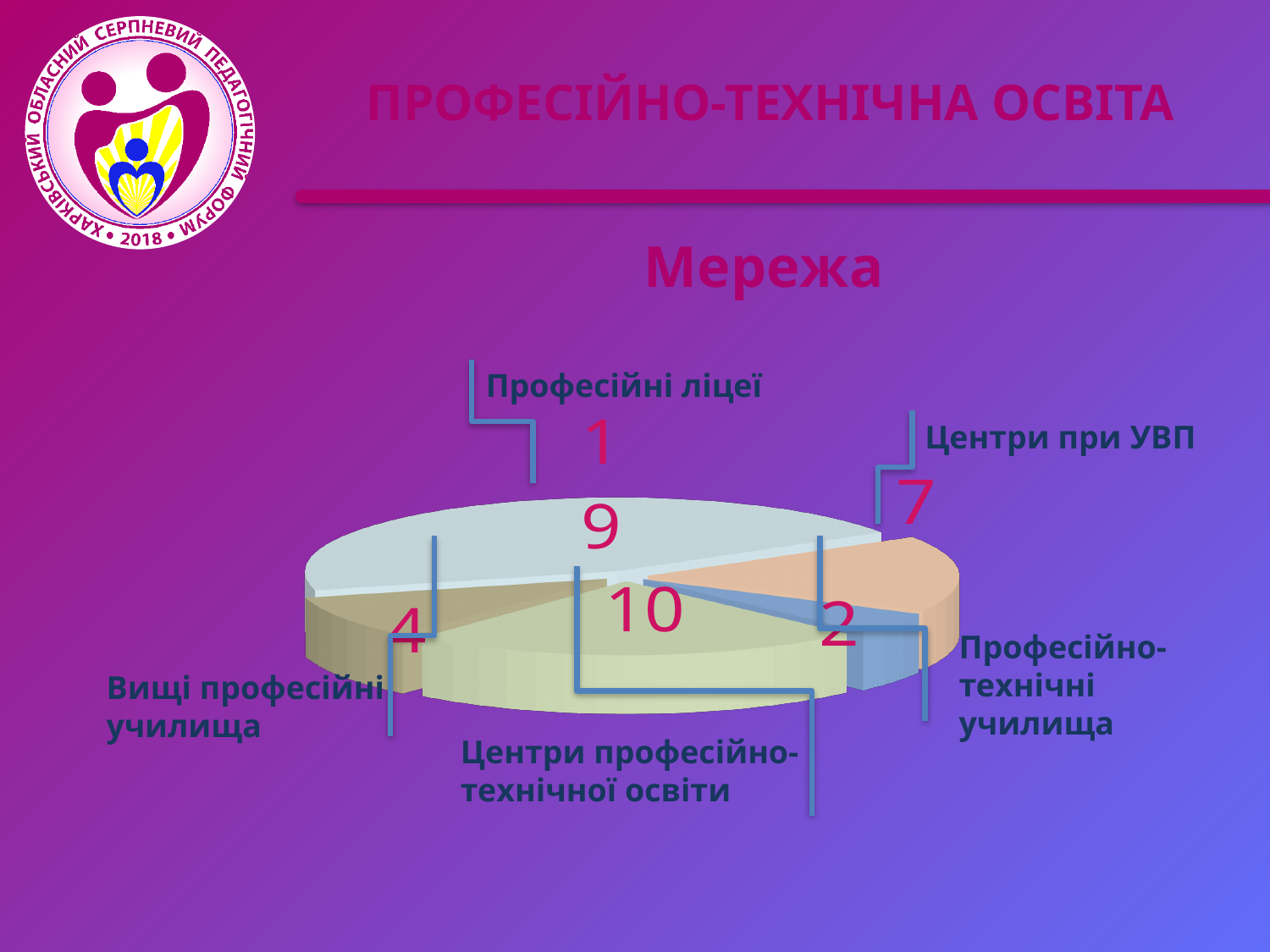
What is the value for Центри професійно-технічної освіти? 10 What is the value for Центри при УВП? 7 What is the title of the chart? Мережа Which is larger: the value for Вищі професійні училища or the value for Професійно-технічні училища? Вищі професійні училища What is the value for Вищі професійні училища? 4 Which category has the smallest slice of the pie? Професійно-технічні училища What kind of chart is shown on the slide? pie chart How many categories (slices) does the pie chart have? 5 What is the difference between the values for Центри професійно-технічної освіти and Центри при УВП? 3 Which category has the largest slice of the pie? Професійні ліцеї What is the difference between the values for Центри при УВП and Вищі професійні училища? 3 What is the value for Професійно-технічні училища? 2